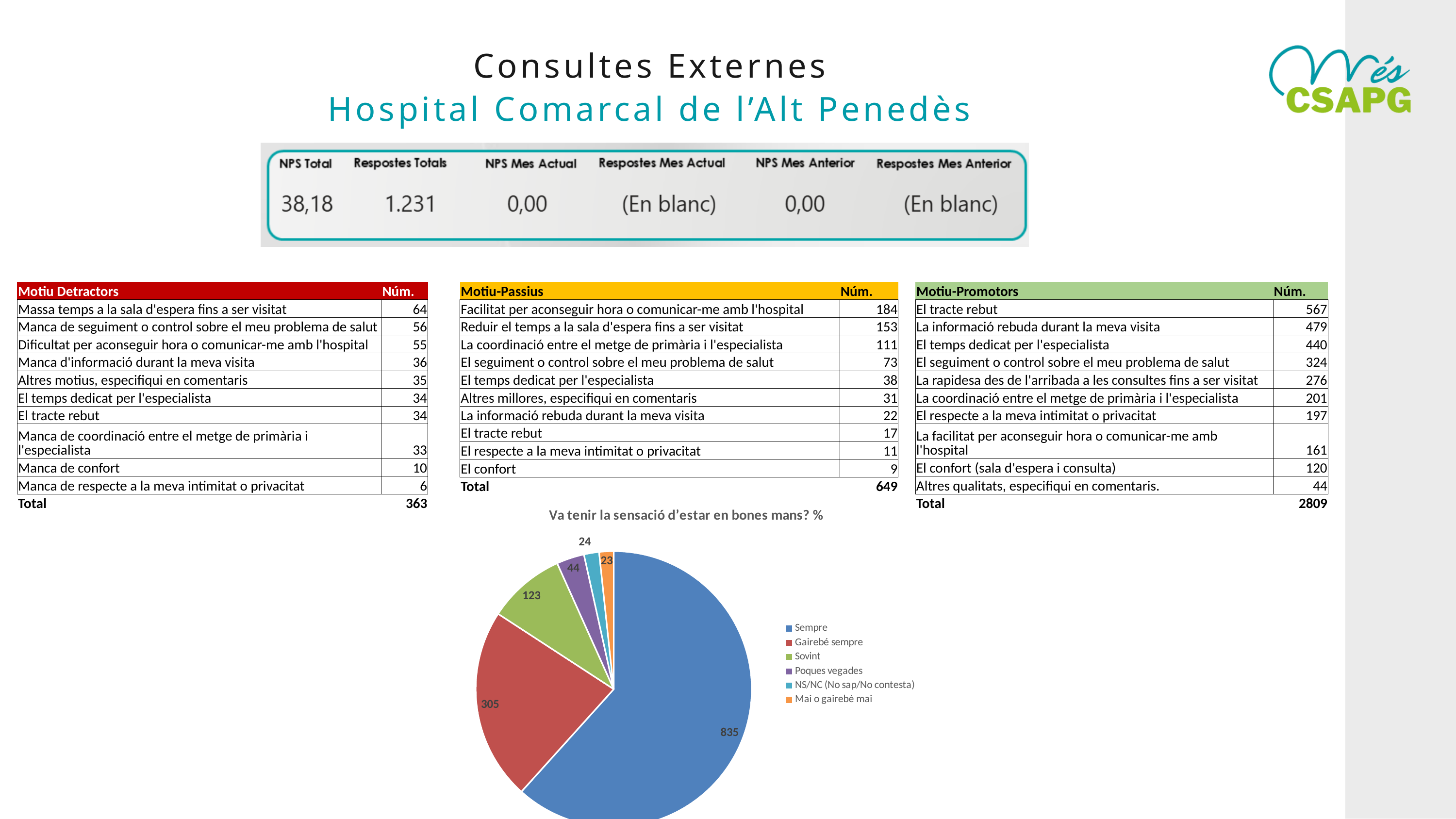
Which category has the largest slice in the pie chart? Sempre What is the difference between the values for Sempre and Gairebé sempre in the pie chart? 530 What is the value for Sovint in the pie chart? 123 What is the value for Gairebé sempre in the pie chart? 305 How many categories does the pie chart legend list? 6 What kind of chart is shown on the slide? pie chart What is the value for Sempre in the pie chart? 835 What is the title of the pie chart? Va tenir la sensació d'estar en bones mans? % What is the value for Poques vegades in the pie chart? 44 Which category has the smallest slice in the pie chart? Mai o gairebé mai What is the value for Mai o gairebé mai in the pie chart? 23 Which is larger in the pie chart, Sovint or Poques vegades? Sovint